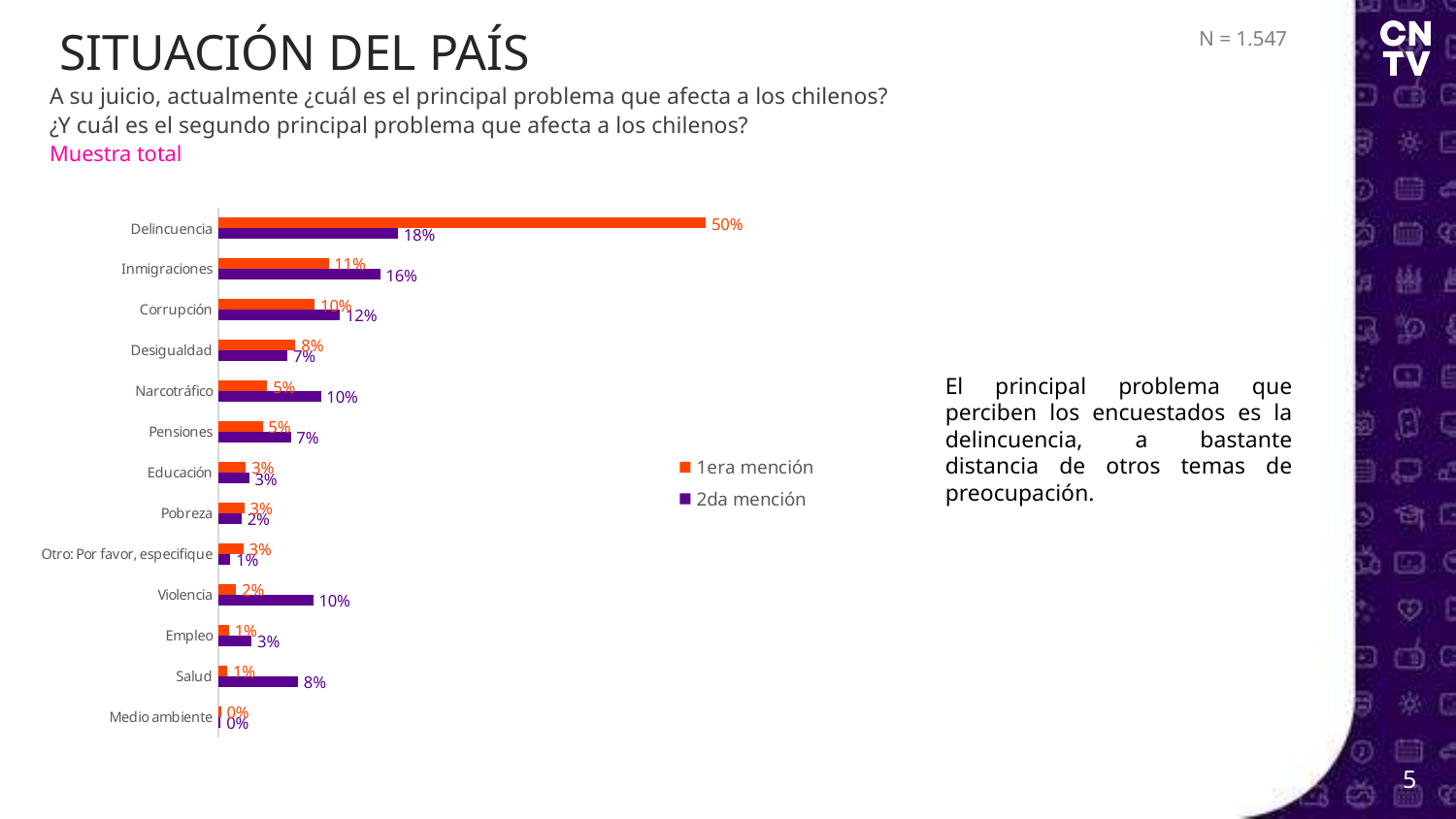
How many categories are shown on the chart? 13 What is the value for Salud in the 2da mención series? 8% How many series does the legend list? 2 What is the value for Inmigraciones in the 2da mención series? 16% What is the difference between the 1era mención and 2da mención values for Delincuencia? 32% Which is larger for Narcotráfico: the 1era mención value or the 2da mención value? 2da mención Which category has the highest value in the 1era mención series? Delincuencia What is the value for Violencia in the 1era mención series? 2% What is the value for Delincuencia in the 1era mención series? 50% Which colour represents the 2da mención series in the legend? Purple What kind of chart is shown on the slide? Bar chart Which category has the lowest value in the 2da mención series? Medio ambiente